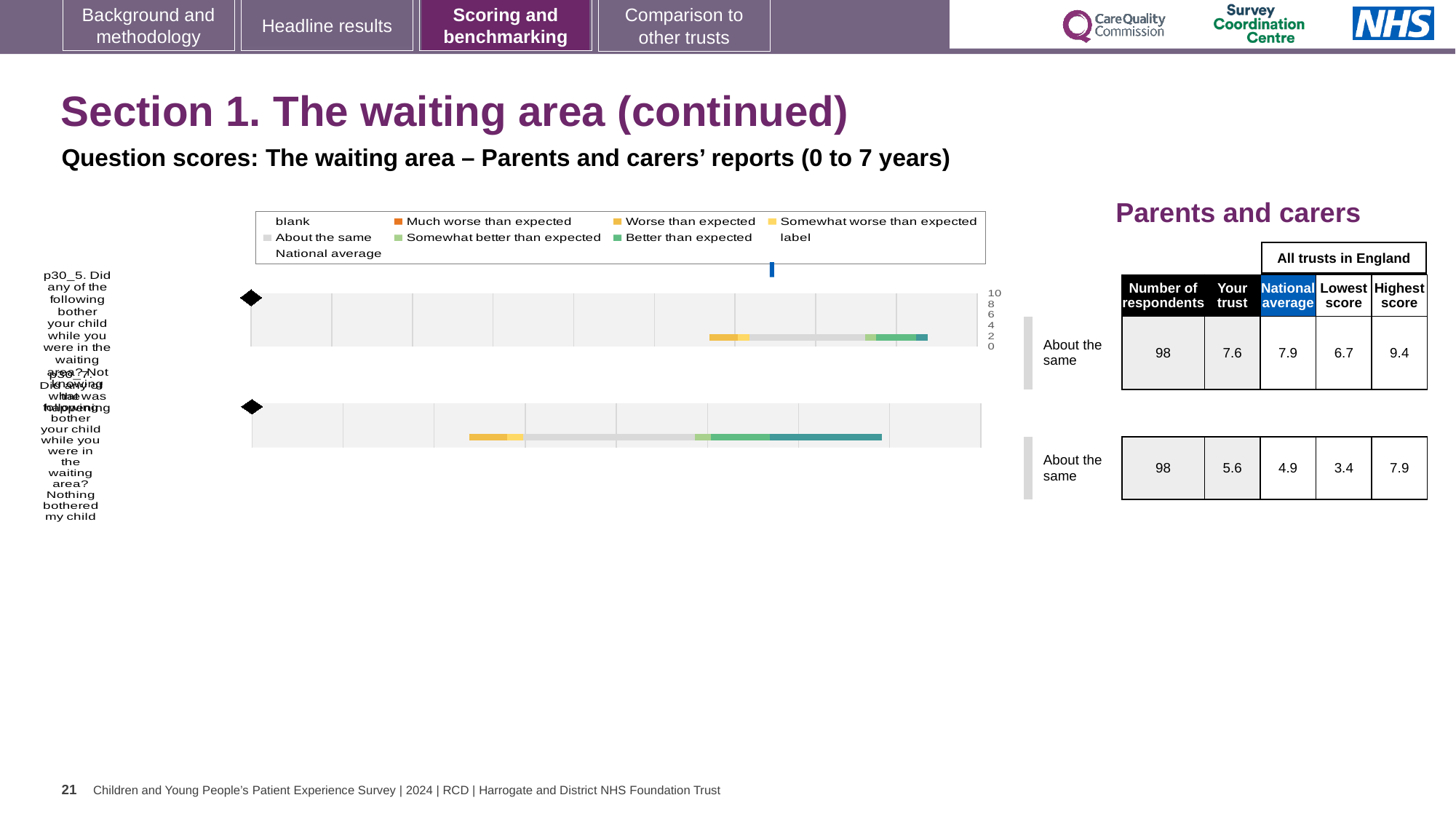
How many respondents answered question p30_5? 98 What is the 'Your trust' score for question p30_7 (Nothing bothered my child)? 5.6 What is the national average score for question p30_7 (Nothing bothered my child)? 4.9 What is the 'Your trust' score for question p30_5 (Did any of the following bother your child while you were in the waiting area? Not knowing what was happening)? 7.6 What is the national average score for question p30_5 (Not knowing what was happening)? 7.9 For question p30_7, which is larger: the 'Your trust' score or the national average? Your trust What kind of chart is shown on the slide? bar chart Which benchmark category is the trust placed in for both questions shown? About the same How many question bars are plotted in the chart? 2 What is the difference between the highest score (7.9) and the lowest score (3.4) across all trusts in England for question p30_7? 4.5 For question p30_5, which is larger: the 'Your trust' score or the national average? National average What is the difference between the highest score (9.4) and the lowest score (6.7) across all trusts in England for question p30_5? 2.7